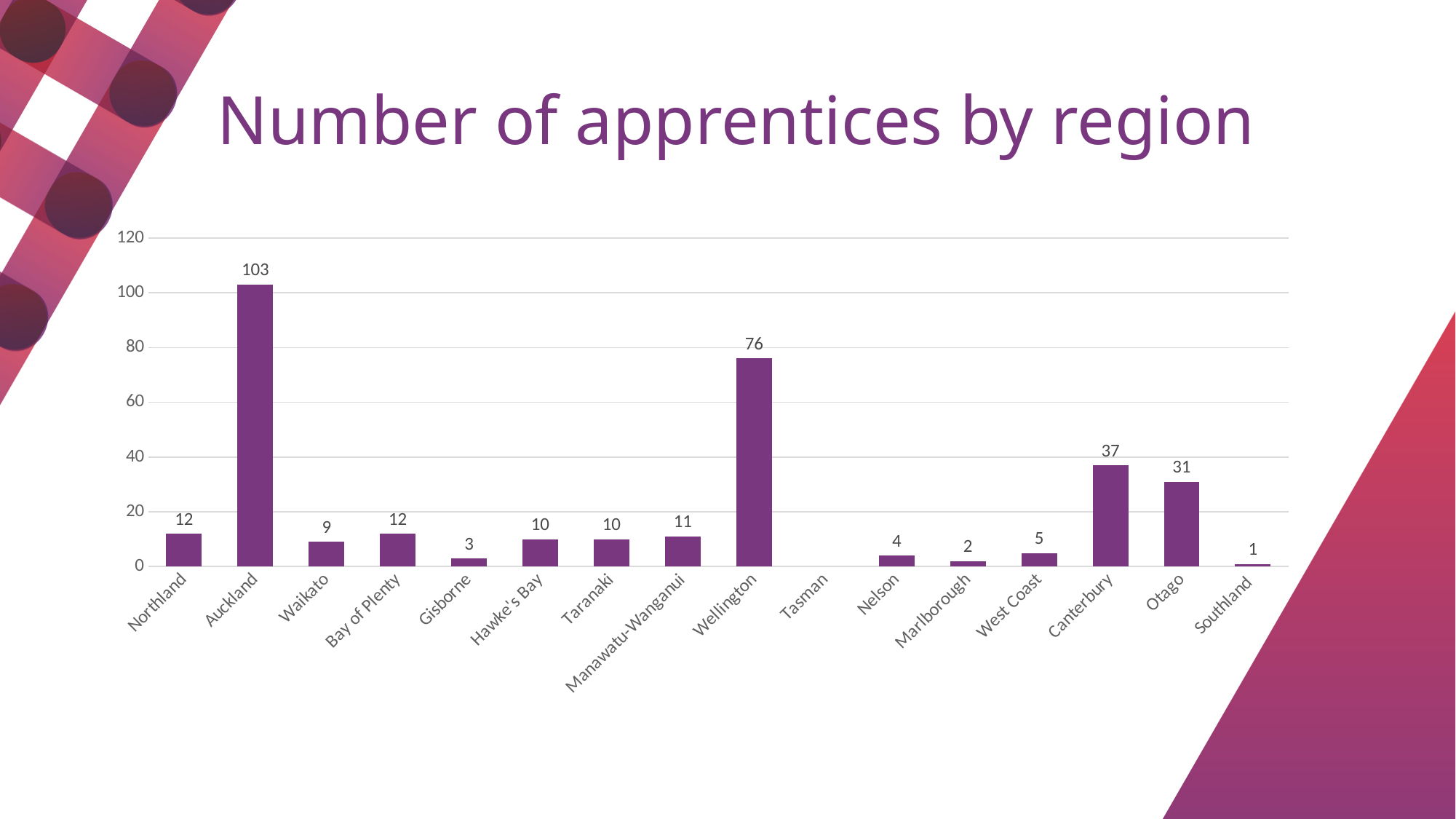
What is the difference between the number of apprentices in Auckland and Wellington? 27 What is the number of apprentices in Wellington? 76 Which region has the highest number of apprentices? Auckland What is the number of apprentices in Canterbury? 37 Is the value for Wellington greater or less than 60? greater Which region has more apprentices, Northland or Waikato? Northland What is the number of apprentices in Auckland? 103 What is the number of apprentices in Gisborne? 3 How many regions are shown on the x axis of the chart? 16 Which region has more apprentices, Otago or Canterbury? Canterbury What kind of chart is shown on the slide? Bar chart What is the difference between the number of apprentices in Canterbury and Otago? 6